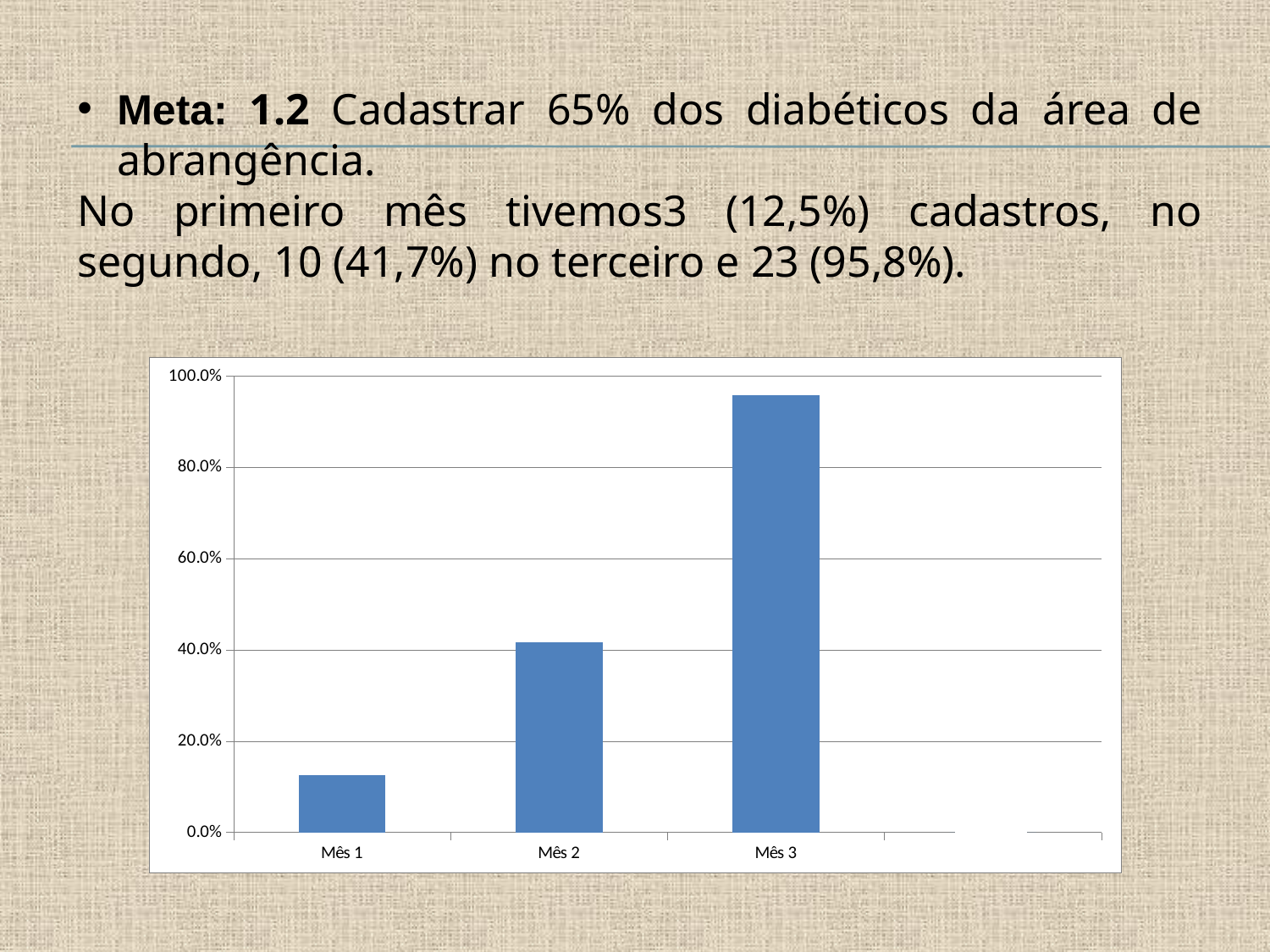
What kind of chart is shown on the slide? bar chart Do the values rise or fall from Mês 1 to Mês 3? rise Is the value for Mês 2 greater or less than 60.0%? less Which month has the lowest bar in the chart? Mês 1 Is the value for Mês 2 greater or less than 40.0%? greater What is the highest tick label shown on the vertical axis? 100.0% How many bars (categories) are plotted in the chart? 3 What colour are the bars in the chart? blue Is the value for Mês 3 greater or less than 80.0%? greater Which month has the highest bar in the chart? Mês 3 Which is larger, the value for Mês 2 or the value for Mês 3? Mês 3